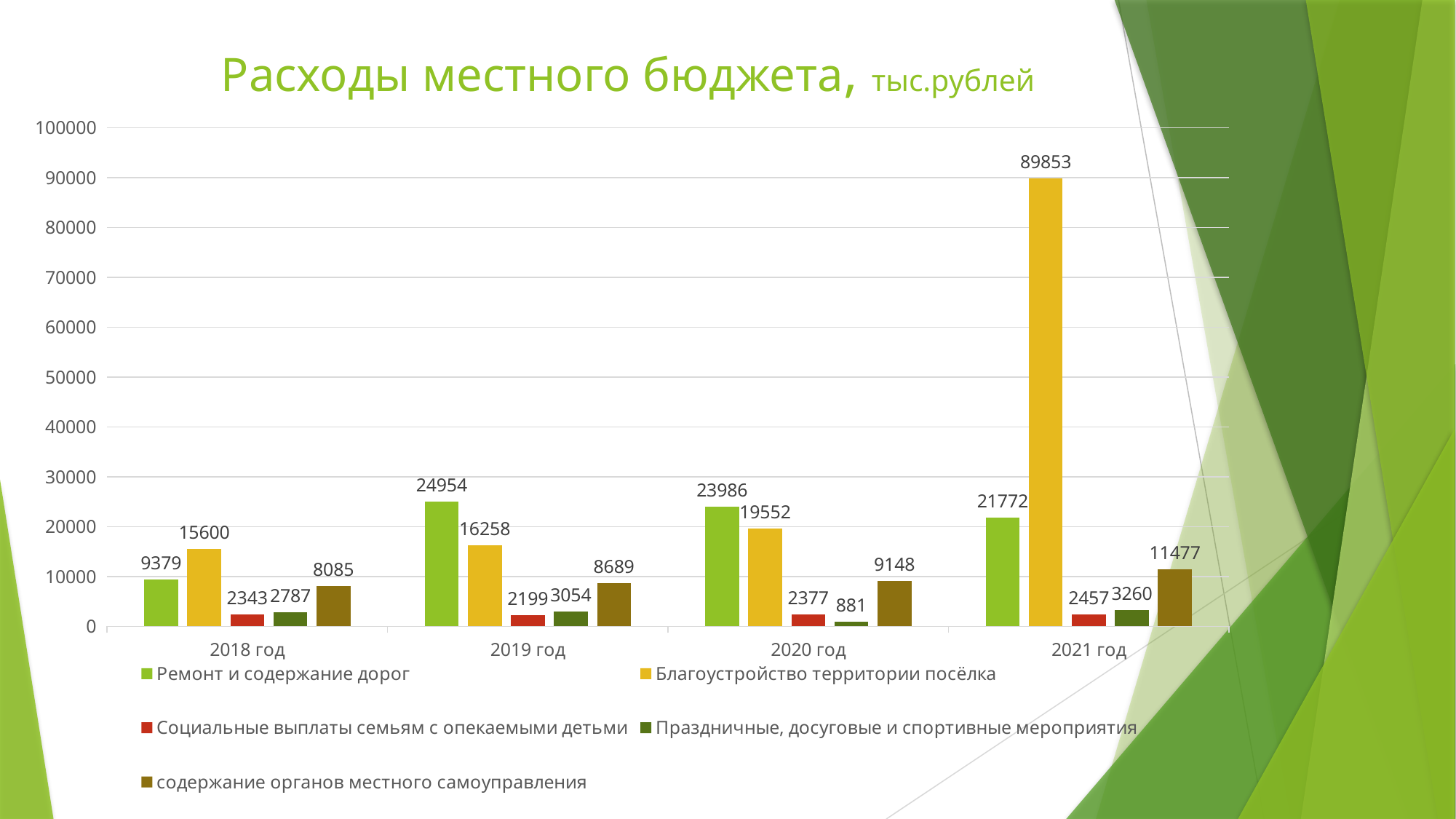
How many years are shown on the x axis? 4 What is the difference between Ремонт и содержание дорог and Благоустройство территории посёлка in 2020 год? 4434 What is the value for Благоустройство территории посёлка in 2021 год? 89853 How many series does the legend list? 5 Which year has the highest value for Благоустройство территории посёлка? 2021 год What is the value for содержание органов местного самоуправления in 2018 год? 8085 What is the title of the chart? Расходы местного бюджета, тыс.рублей Which year has the lowest value for Социальные выплаты семьям с опекаемыми детьми? 2019 год Which is larger in 2018 год: Ремонт и содержание дорог or Благоустройство территории посёлка? Благоустройство территории посёлка What kind of chart is shown on the slide? Bar chart What is the value for Праздничные, досуговые и спортивные мероприятия in 2020 год? 881 What is the value for Ремонт и содержание дорог in 2019 год? 24954